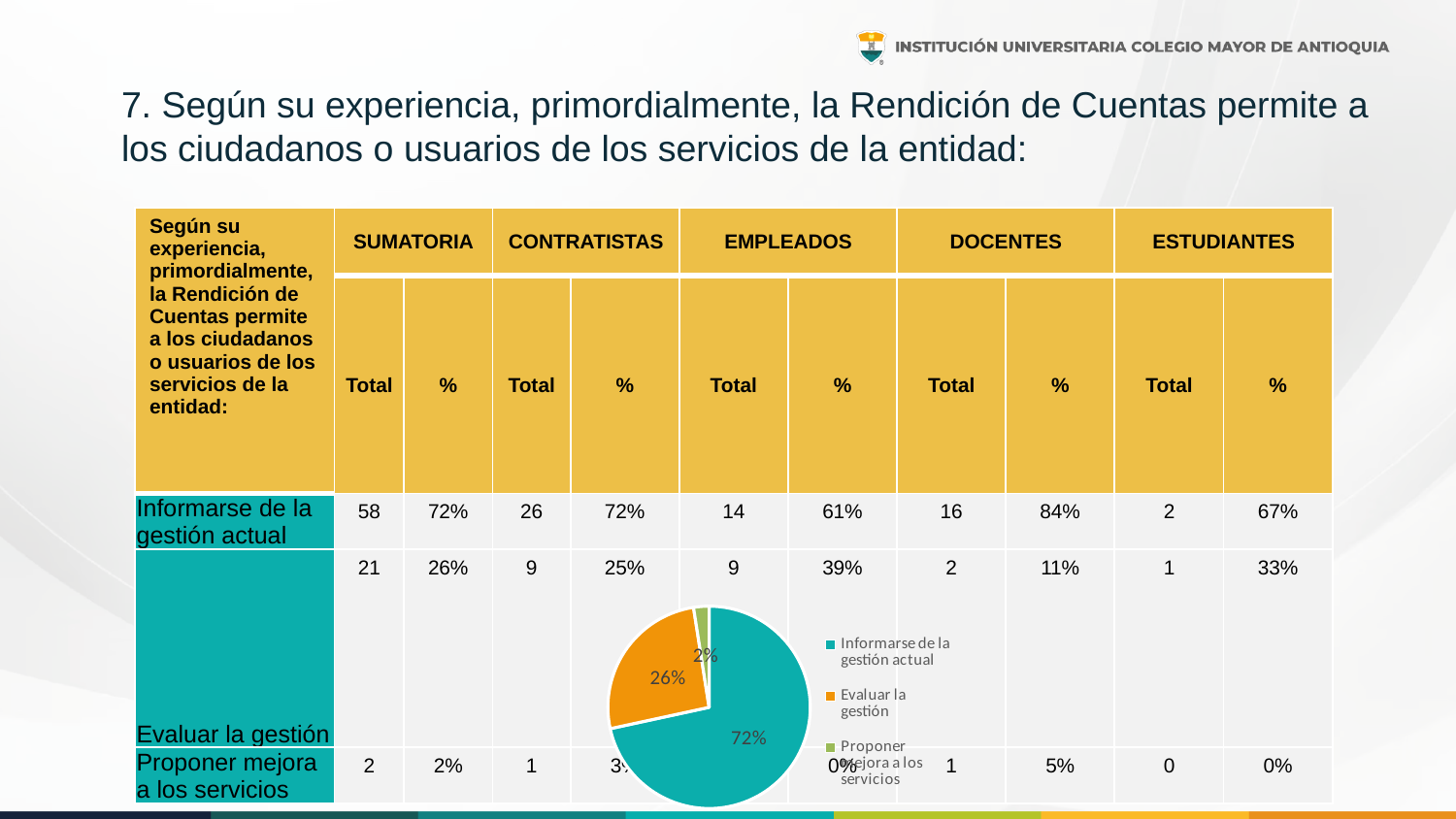
Which is larger in the pie chart: "Evaluar la gestión" or "Proponer mejora a los servicios"? Evaluar la gestión What share of the pie does "Informarse de la gestión actual" represent? 72% How many entries does the pie chart's legend list? 3 What is the difference in percentage points between the "Informarse de la gestión actual" slice and the "Evaluar la gestión" slice? 46 Which slice of the pie chart is the largest? Informarse de la gestión actual What kind of chart is shown on the slide? pie chart Which slice of the pie chart is the smallest? Proponer mejora a los servicios How many slices does the pie chart have? 3 What colour is the "Informarse de la gestión actual" slice in the pie chart? teal What colour is the "Evaluar la gestión" slice in the pie chart? orange What share of the pie does "Evaluar la gestión" represent? 26% What share of the pie does "Proponer mejora a los servicios" represent? 2%